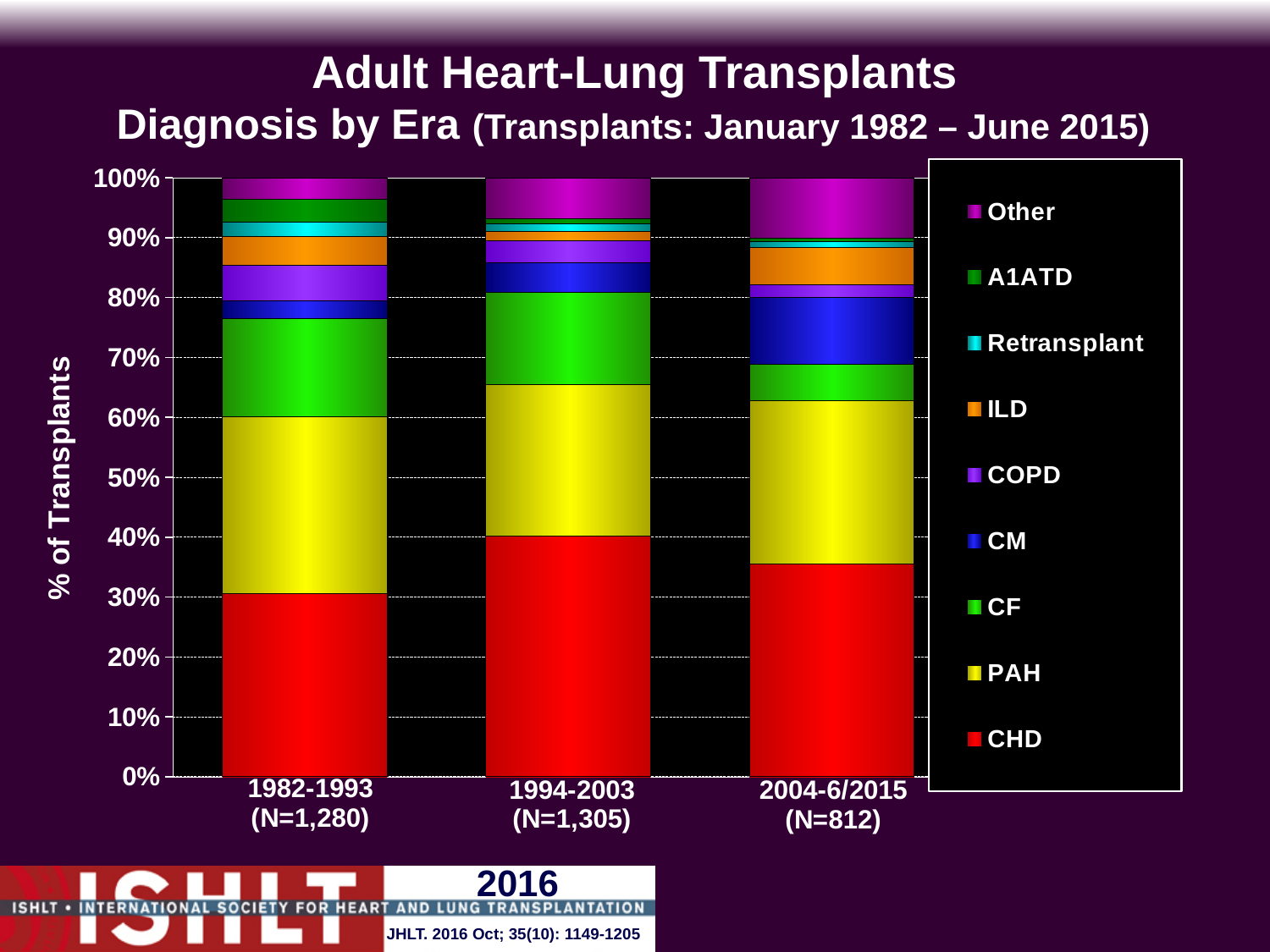
Is the CHD share for 2004-6/2015 greater or less than 30%? greater Is the CHD share for 2004-6/2015 greater or less than 40%? less What kind of chart is shown on the slide? Stacked bar chart Which era has the largest CHD share? 1994-2003 How many diagnosis series does the legend list? 9 What is the N value printed for the 2004-6/2015 era? N=812 Is the cumulative top of the PAH segment for 1994-2003 greater or less than 60%? greater How many era categories are plotted along the x axis? 3 What is the label of the y axis? % of Transplants Which diagnosis is shown at the bottom of each stacked bar? CHD Which era has the larger CHD share, 1982-1993 or 1994-2003? 1994-2003 What is the N value printed for the 1982-1993 era? N=1,280